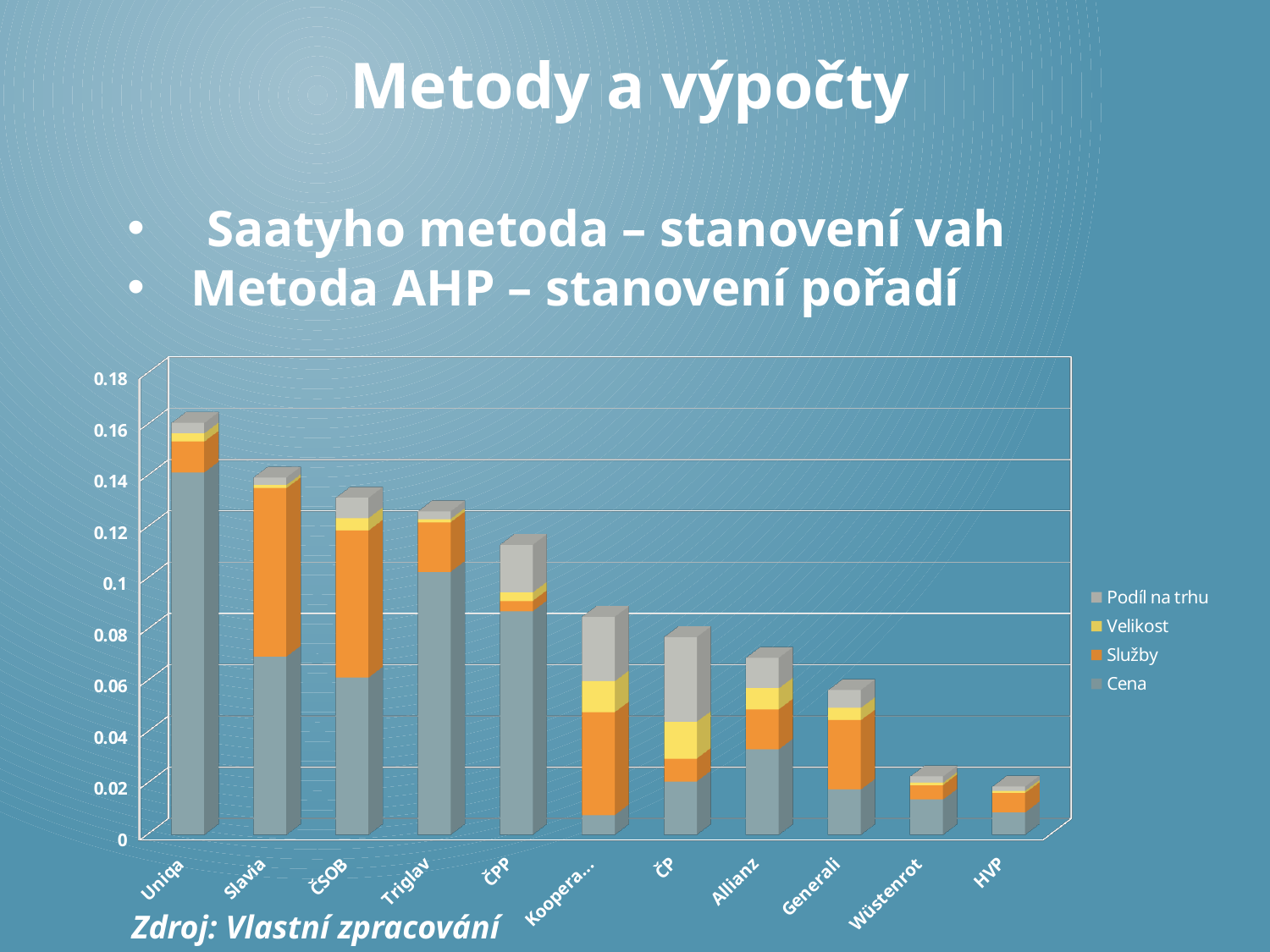
Is the total value for Uniqa greater or less than 0.14? greater How many series does the chart legend list? 4 How many insurance companies (categories) are shown on the x axis of the chart? 11 Is the total value for HVP greater or less than 0.04? less What source is cited below the chart? Zdroj: Vlastní zpracování Which has the larger total bar, Generali or Triglav? Triglav Which series is listed first in the chart legend? Podíl na trhu Is the total value for Slavia greater or less than 0.12? greater Do the total bar heights rise or fall moving from left to right along the x axis? Fall Which has the larger total bar, Uniqa or Slavia? Uniqa Which company has the highest total bar in the chart? Uniqa What kind of chart is shown on the slide? Stacked bar chart